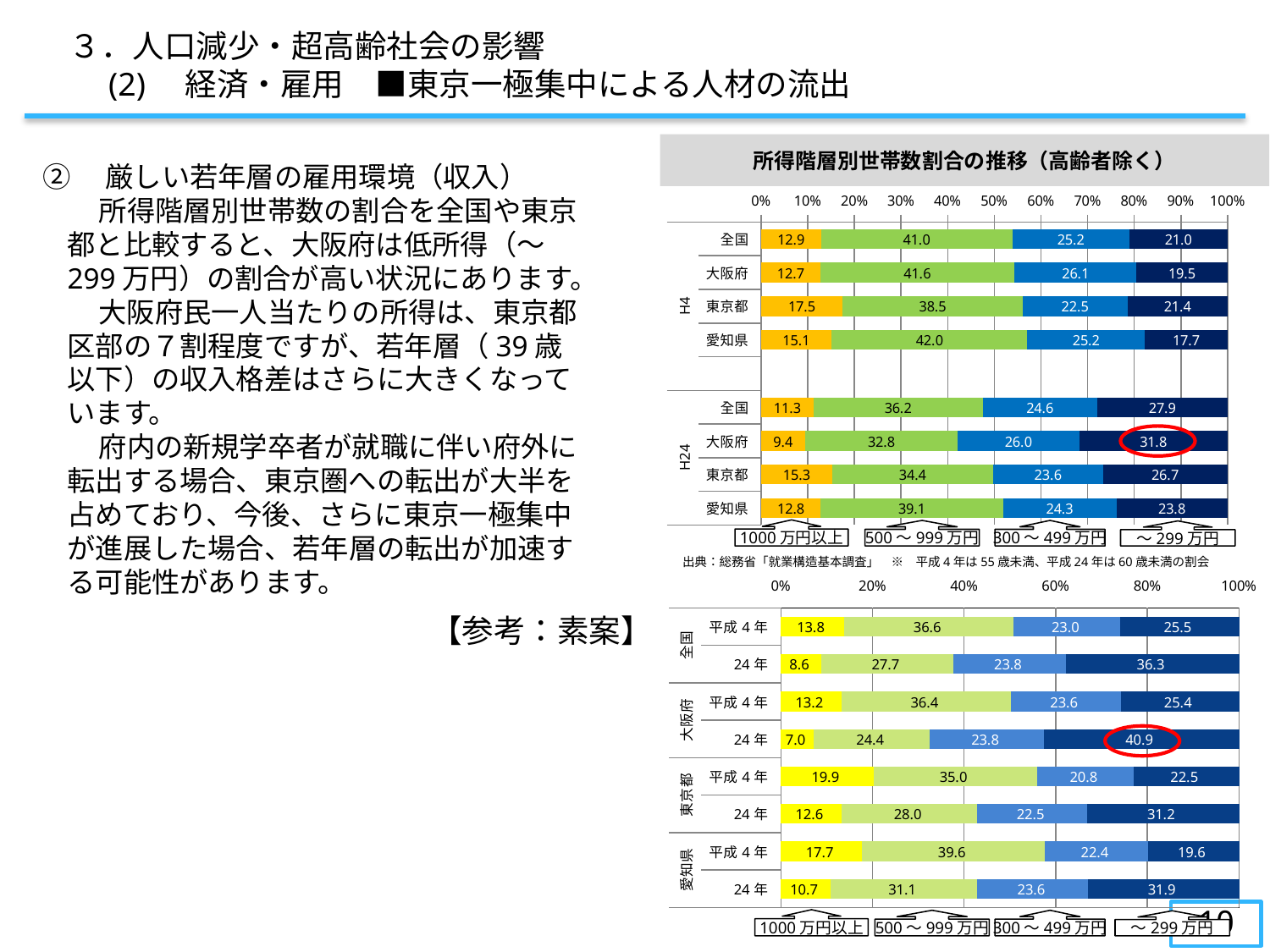
In the top chart titled 所得階層別世帯数割合の推移（高齢者除く）, which region has the highest ～299万円 share in H24? 大阪府 In the bottom chart, how many bars are plotted in total? 8 In the top chart titled 所得階層別世帯数割合の推移（高齢者除く）, what is the value of the ～299万円 segment for 大阪府 in H24? 31.8 In the bottom chart, what is the value of the 500～999万円 segment for 愛知県 in 平成4年? 39.6 In the top chart titled 所得階層別世帯数割合の推移（高齢者除く）, what is the difference between the ～299万円 share for 大阪府 in H24 and in H4? 12.3 In the top chart titled 所得階層別世帯数割合の推移（高齢者除く）, which region has the lowest 1000万円以上 share in H24? 大阪府 In the bottom chart, which is larger: the 1000万円以上 share for 東京都 in 平成4年 or for 愛知県 in 平成4年? 東京都 in 平成4年 In the bottom chart, what is the value of the ～299万円 segment for 大阪府 in 24年? 40.9 What kind of chart is the top chart titled 所得階層別世帯数割合の推移（高齢者除く）? Stacked bar chart In the bottom chart, what is the difference between the 1000万円以上 share for 全国 in 平成4年 and in 24年? 5.2 In the top chart titled 所得階層別世帯数割合の推移（高齢者除く）, what is the value of the 1000万円以上 segment for 東京都 in H4? 17.5 In the top chart titled 所得階層別世帯数割合の推移（高齢者除く）, how many series does the legend list? 4